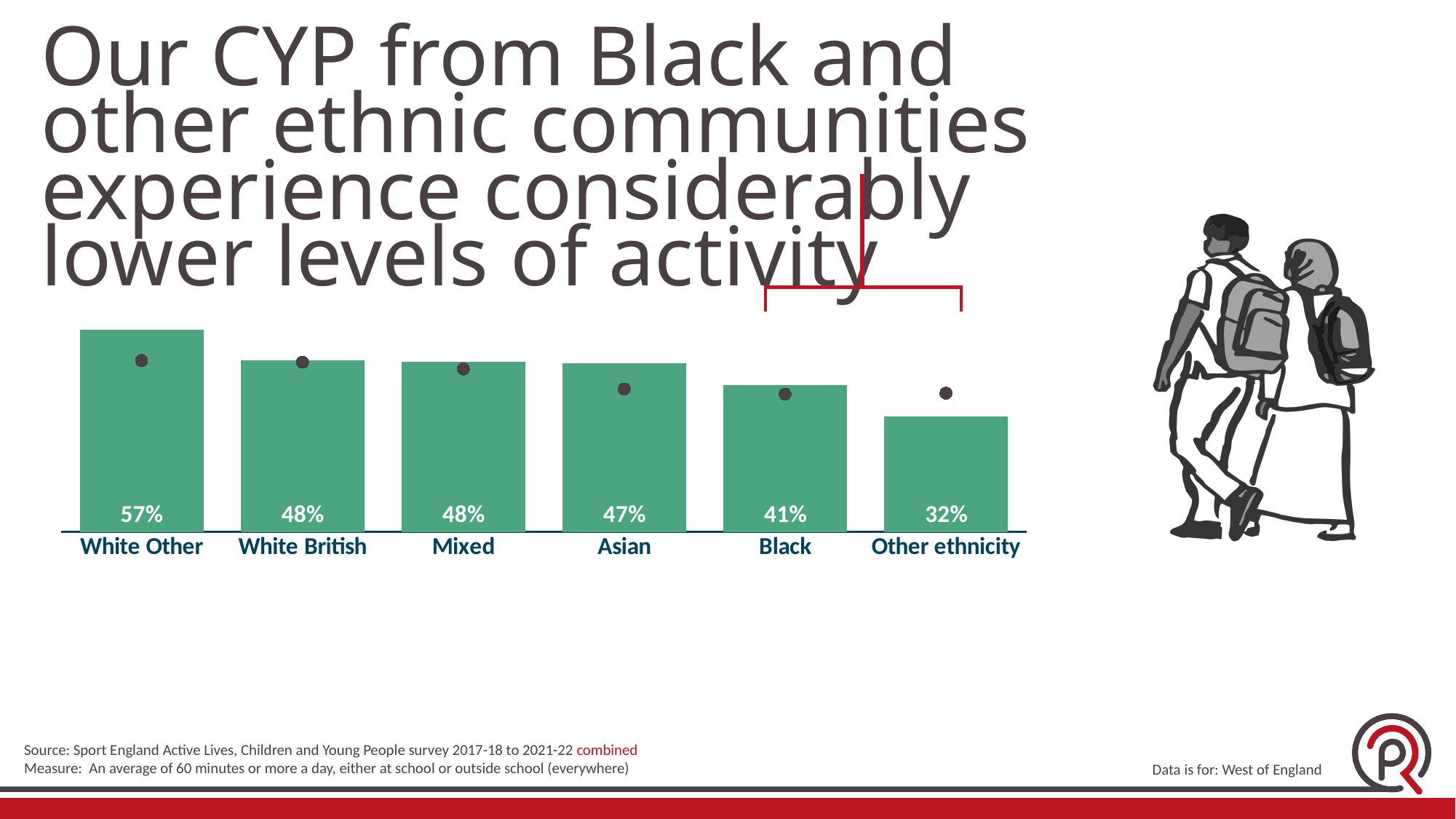
How many categories are shown in the chart? 6 What is the value for White Other? 57% What is the value for Black? 41% Which category has the highest value? White Other What is the value for Other ethnicity? 32% What is the value for Asian? 47% What is the difference between the values for White Other and Other ethnicity? 25% Which category has the lowest value? Other ethnicity Which is larger, the value for Asian or the value for Black? Asian What kind of chart is shown on the slide? Bar chart What is the difference between the values for White British and Black? 7% Do the bar values rise or fall from left to right across the categories? Fall